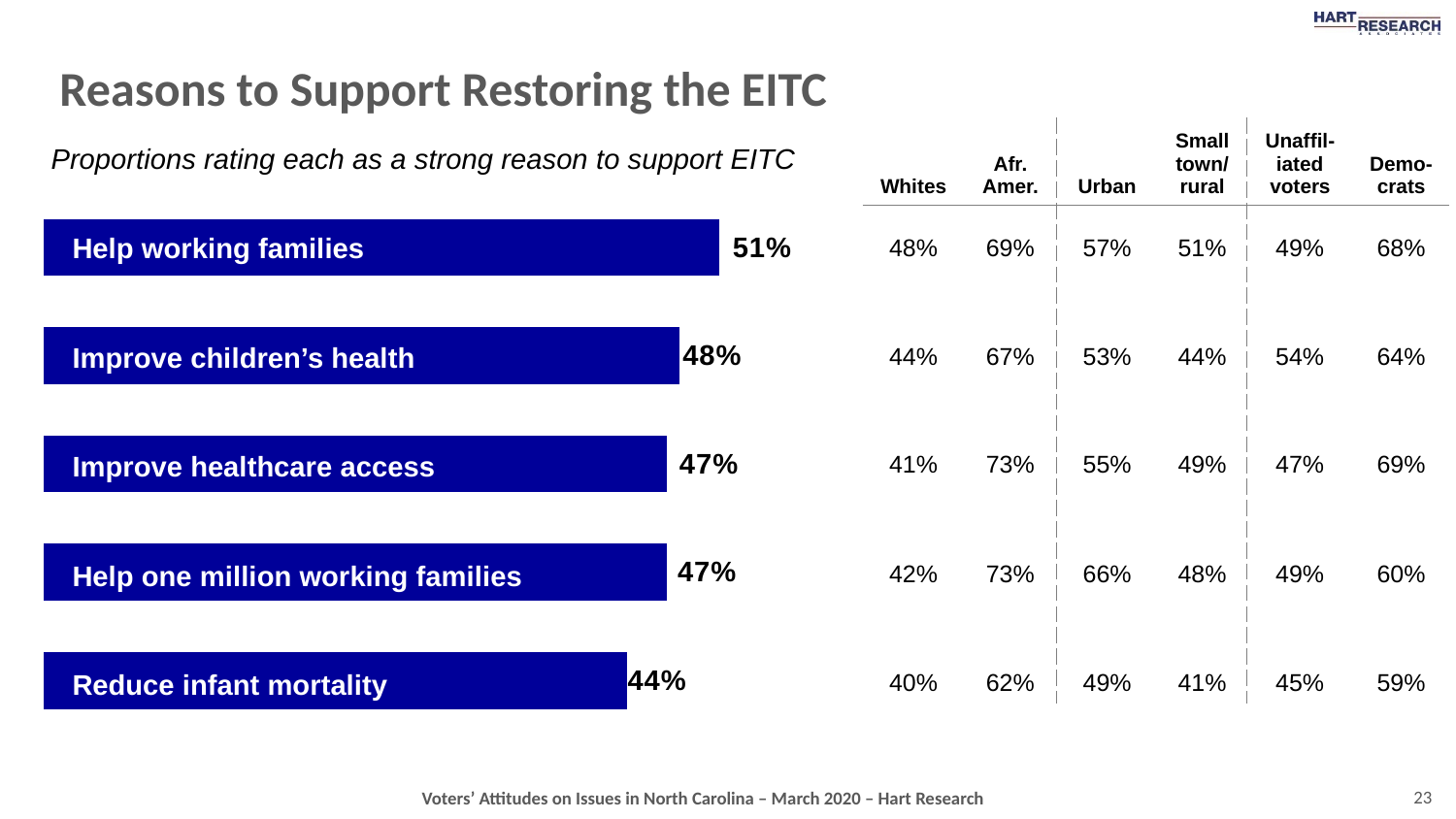
Which is larger: the value for "Improve children's health" or the value for "Improve healthcare access"? Improve children's health What is the value shown for "Improve children's health"? 48% How many reasons are shown as bars in the chart? 5 Which reason has the lowest proportion rating it a strong reason to support EITC? Reduce infant mortality Do the bar values increase or decrease from the top bar to the bottom bar? Decrease What is the value shown for "Help one million working families"? 47% Which reason has the highest proportion rating it a strong reason to support EITC? Help working families What percentage of voters rate "Help working families" as a strong reason to support EITC? 51% What is the difference in percentage points between "Help working families" and "Reduce infant mortality"? 7 What is the value shown for "Reduce infant mortality"? 44% What is the title of the slide containing the chart? Reasons to Support Restoring the EITC What kind of chart is used to show the proportions rating each reason? Bar chart